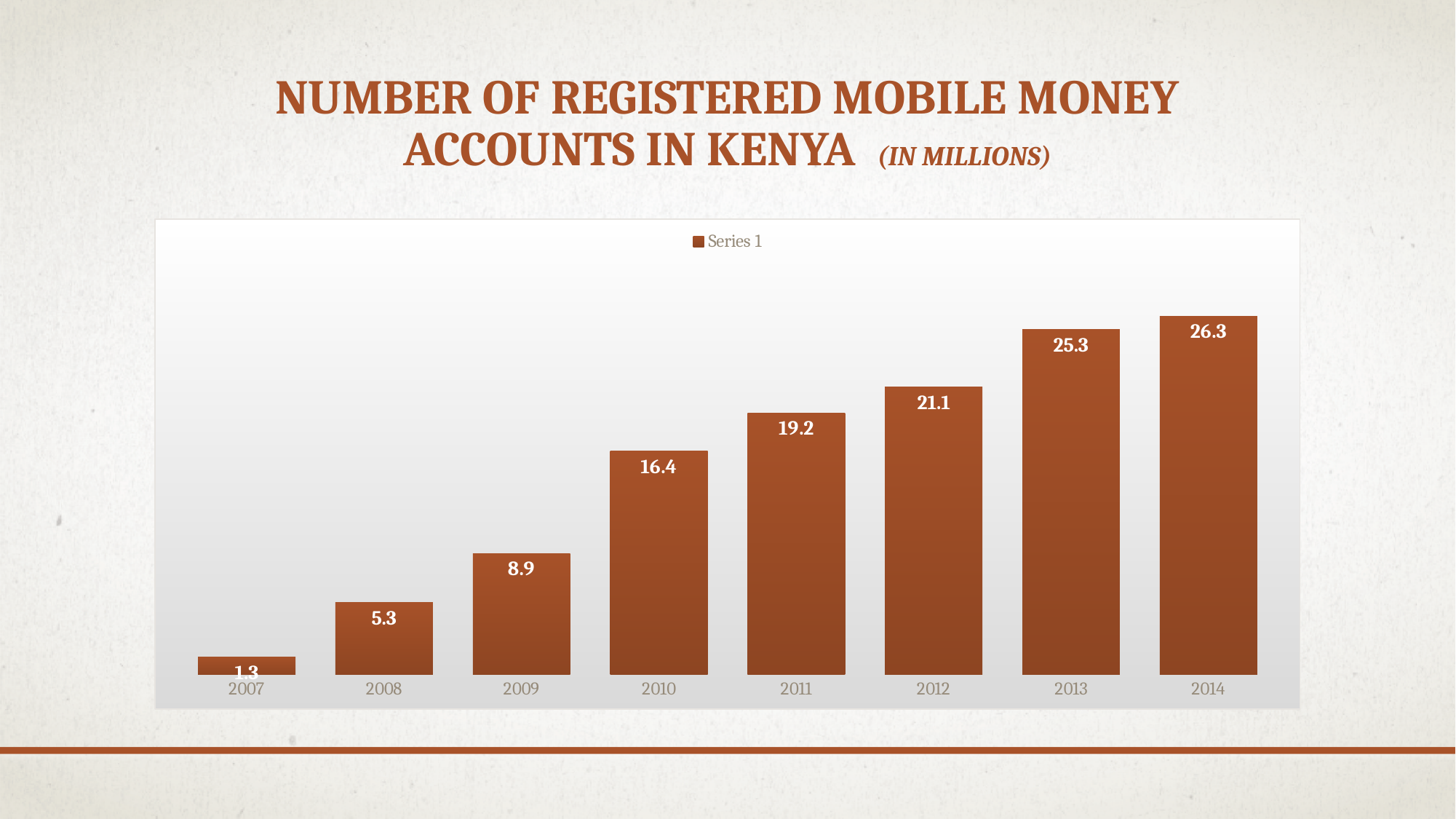
What is the difference between the values for 2014 and 2013? 1.0 Which is larger, the value for 2011 or the value for 2012? 2012 Which year has the lowest value? 2007 How many series does the legend list? 1 How many years are shown on the x axis? 8 What is the difference between the values for 2010 and 2009? 7.5 What is the value for 2013? 25.3 What kind of chart is shown on the slide? Bar chart What is the value for 2010? 16.4 Which year has the highest value? 2014 Do the values rise or fall from 2007 to 2014? Rise What is the value for 2007? 1.3